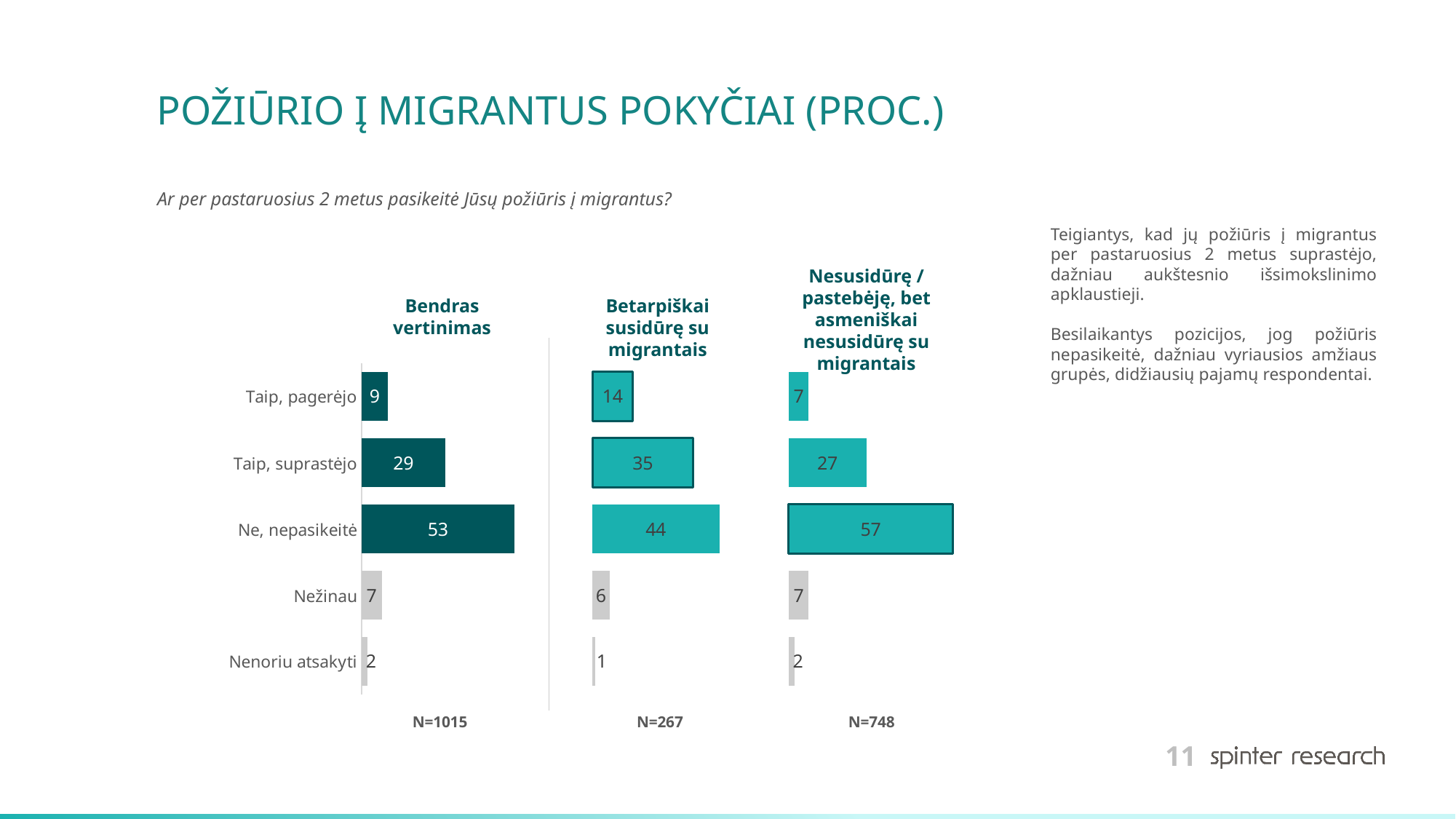
What is the title of the slide? POŽIŪRIO Į MIGRANTUS POKYČIAI (PROC.) In the "Betarpiškai susidūrę su migrantais" chart, which category has the lowest value? Nenoriu atsakyti Which is larger: "Taip, pagerėjo" in the "Betarpiškai susidūrę su migrantais" chart or "Taip, pagerėjo" in the "Bendras vertinimas" chart? Betarpiškai susidūrę su migrantais In the "Bendras vertinimas" chart, what is the difference between "Ne, nepasikeitė" and "Taip, suprastėjo"? 24 In the "Nesusidūrę / pastebėję, bet asmeniškai nesusidūrę su migrantais" chart, what is the value for "Taip, pagerėjo"? 7 In the "Bendras vertinimas" chart, which category has the highest value? Ne, nepasikeitė What is the sample size (N) shown under the "Betarpiškai susidūrę su migrantais" chart? N=267 In the "Bendras vertinimas" chart, what is the value for "Ne, nepasikeitė"? 53 In the "Nesusidūrę / pastebėję, bet asmeniškai nesusidūrę su migrantais" chart, what is the difference between "Ne, nepasikeitė" and "Taip, suprastėjo"? 30 How many categories does the "Bendras vertinimas" chart show? 5 In the "Betarpiškai susidūrę su migrantais" chart, what is the value for "Taip, suprastėjo"? 35 What kind of chart is used on this slide? Bar chart